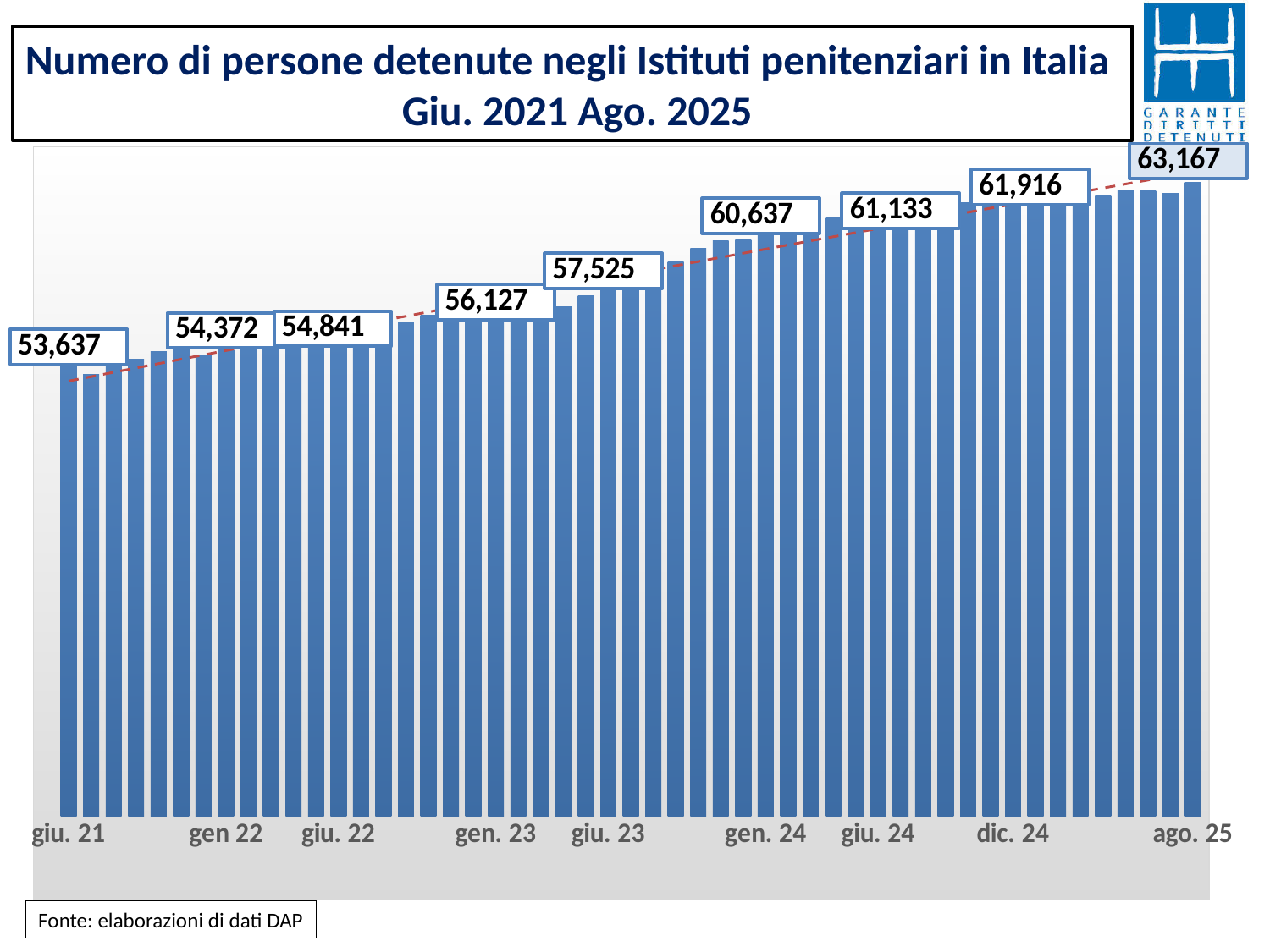
Which is larger, the value for giu. 24 or the value for dic. 24? dic. 24 What is the difference between the values for gen. 24 and giu. 23? 3,112 What is the number of detained persons shown for ago. 25? 63,167 Which labelled period has the lowest number of detained persons? giu. 21 What value is labelled for gen. 24? 60,637 What is the number of detained persons shown for giu. 21? 53,637 Do the values generally rise or fall from giu. 21 to ago. 25? rise What is the difference between the values for ago. 25 and giu. 21? 9,530 What value is labelled for giu. 23? 57,525 Which labelled period has the highest number of detained persons? ago. 25 What value is labelled for dic. 24? 61,916 What kind of chart is shown on the slide? bar chart